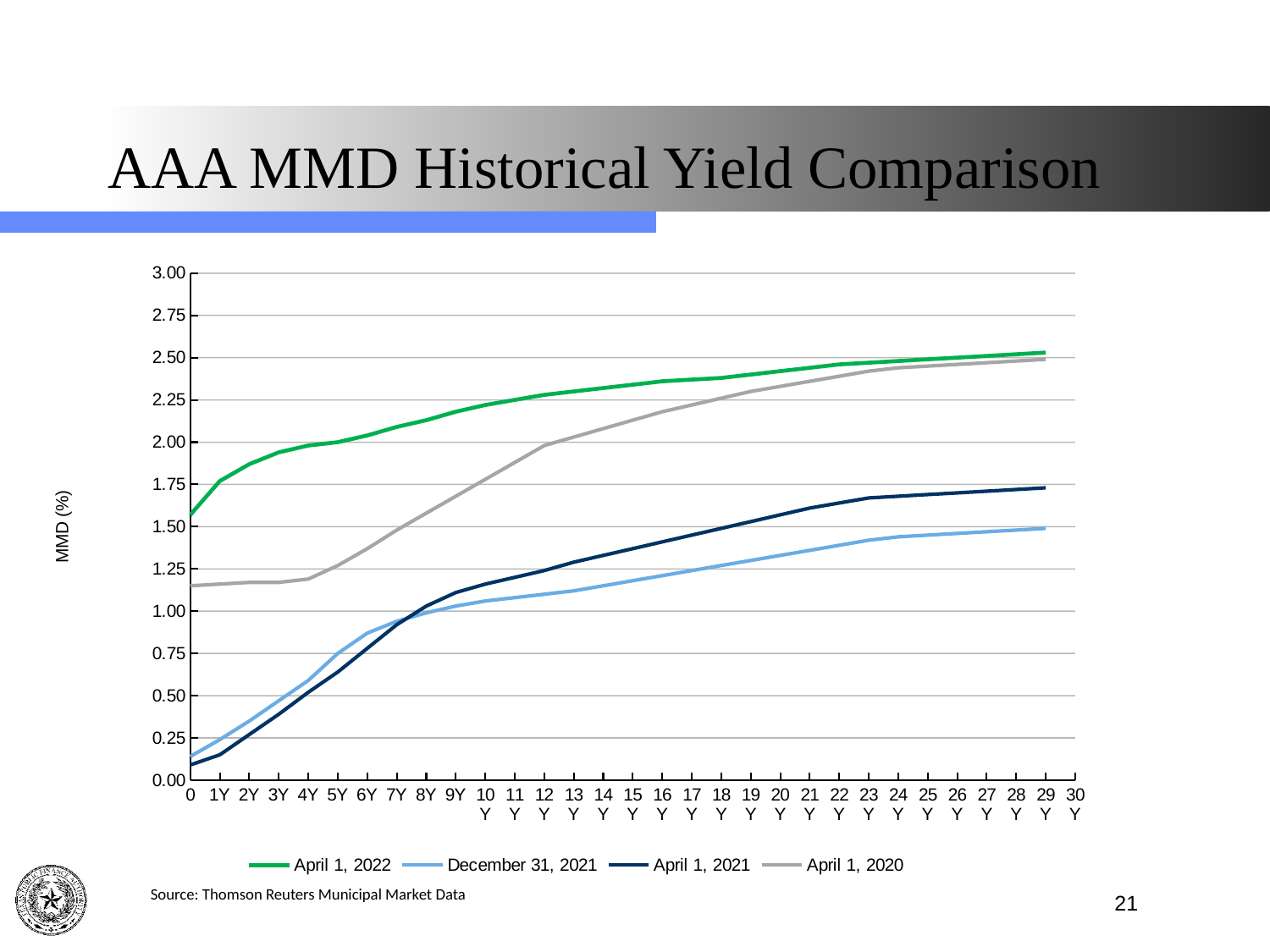
Does the April 1, 2022 series rise or fall as the maturity increases along the x axis? rise Is the value for April 1, 2020 at 5Y greater or less than 1.50? less What kind of chart is shown on the slide? line chart What is the title of the chart? AAA MMD Historical Yield Comparison How many series does the legend list? 4 Is the value for April 1, 2022 at 1Y greater or less than 1.50? greater Which series has the highest value at 10Y? April 1, 2022 Is the value for April 1, 2022 at 12Y greater or less than 2.00? greater What is the label on the vertical axis? MMD (%) At 5Y, which series has the higher value: April 1, 2022 or April 1, 2021? April 1, 2022 At 20Y, which series has the higher value: April 1, 2020 or April 1, 2021? April 1, 2020